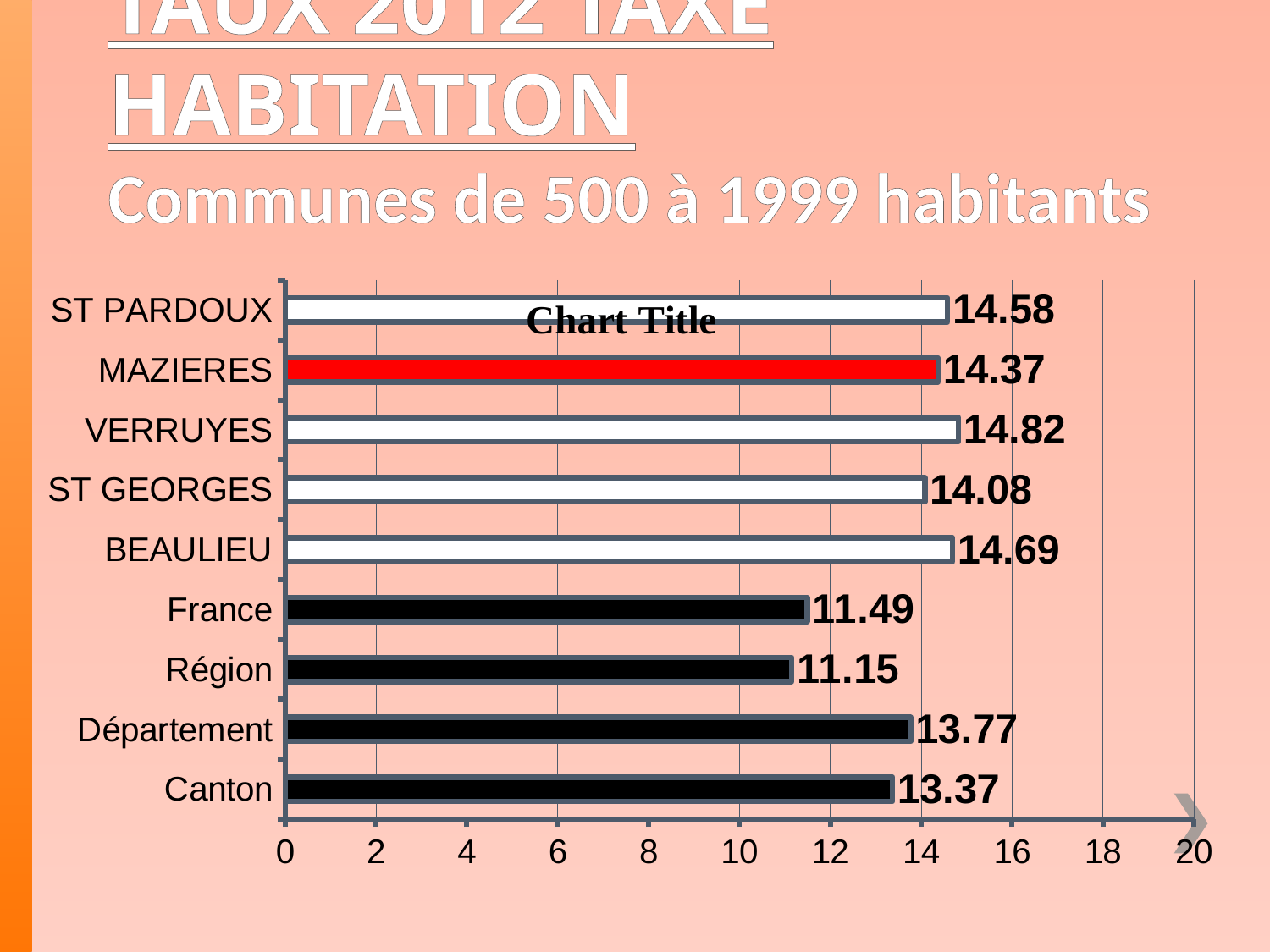
What is the difference between the values for VERRUYES and MAZIERES? 0.45 Which is larger, the value for ST PARDOUX or the value for BEAULIEU? BEAULIEU How many categories are shown in the chart? 9 Is the value for Canton greater or less than 14? less What is the value for MAZIERES? 14.37 What is the value for Région? 11.15 What is the value for Département? 13.77 What is the difference between the values for France and Région? 0.34 Which category's bar is coloured red? MAZIERES Which category has the lowest value? Région What kind of chart is shown on the slide? bar chart Which category has the highest value? VERRUYES